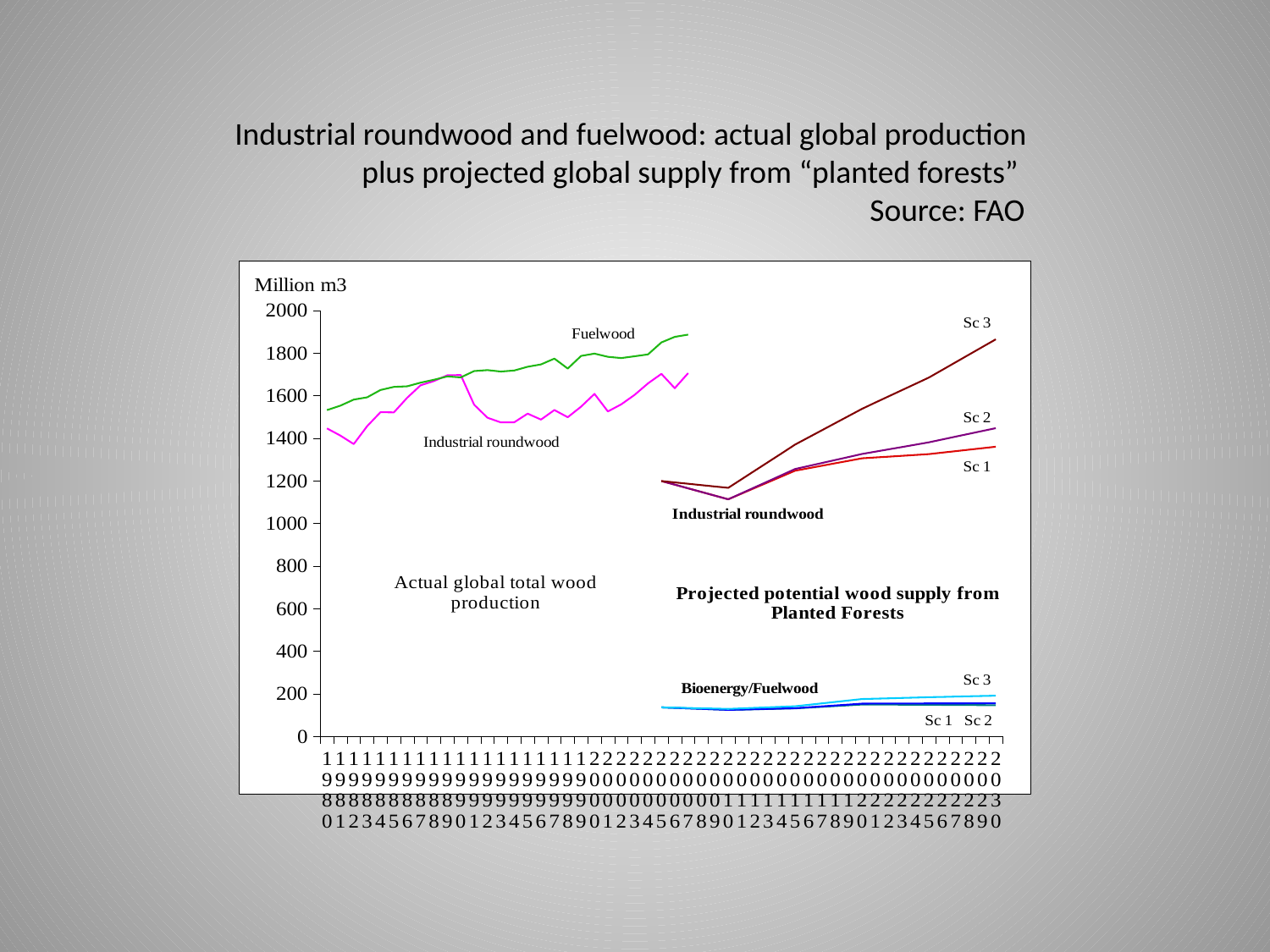
How many projection scenarios are labelled for Industrial roundwood in the chart? 3 What unit is shown on the y axis of the chart? Million m3 In 2030, which projected Industrial roundwood scenario is higher, Sc 3 or Sc 1? Sc 3 Is the value for Fuelwood in 1980 greater or less than 1400? greater Does the projected Sc 3 line for Industrial roundwood rise or fall from 2010 to 2030? rise Does the actual Fuelwood production line rise or fall from 1980 to 2010? rise Is the projected Sc 1 value for Industrial roundwood in 2030 greater or less than 1400? less Around 2010, which actual production line is higher, Fuelwood or Industrial roundwood? Fuelwood Is the projected Sc 3 value for Bioenergy/Fuelwood in 2030 greater or less than 400? less What kind of chart is shown on the slide? line chart What source is cited for the chart? FAO